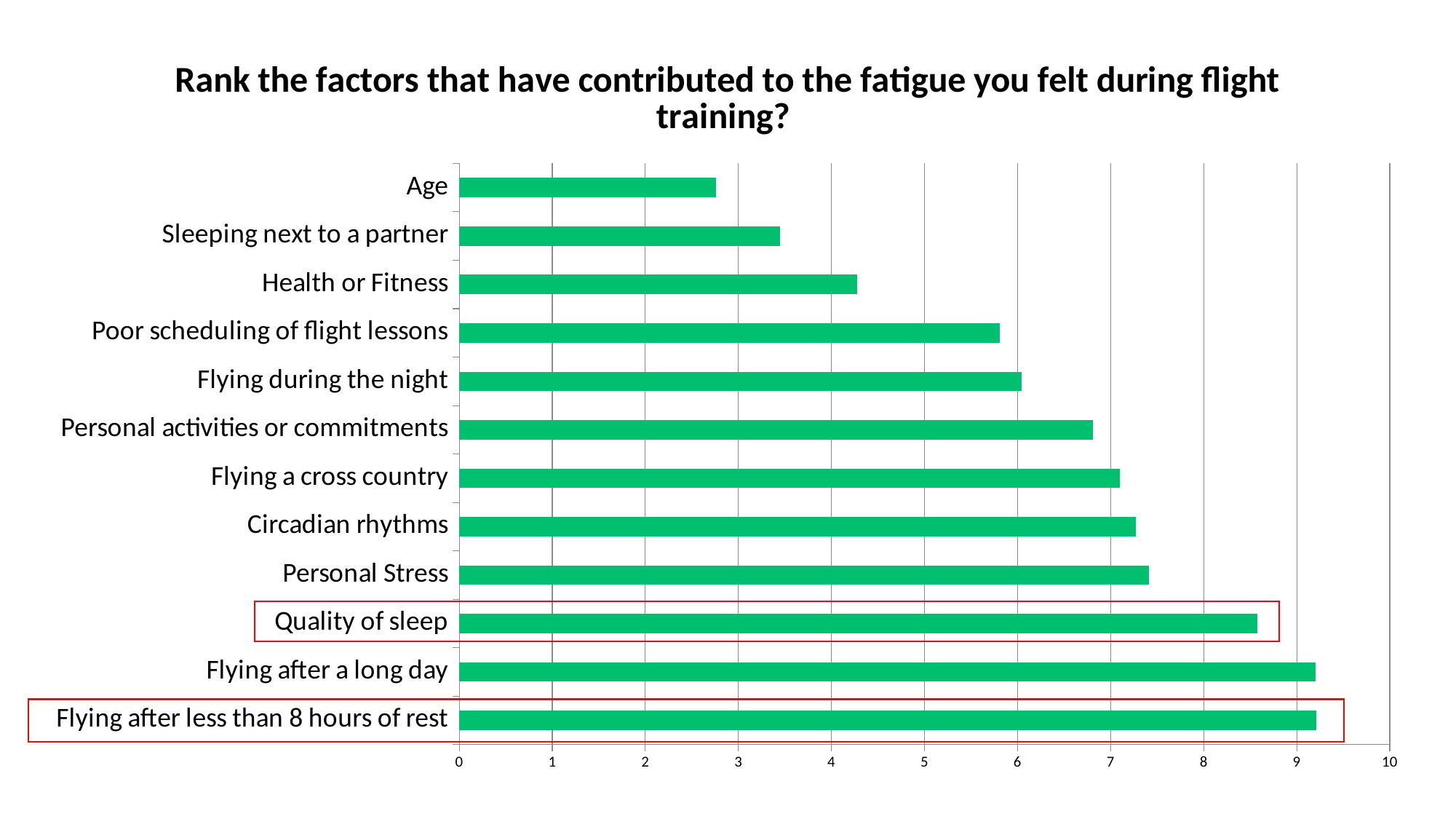
Is the value for Flying during the night greater or less than 5? greater What kind of chart is shown on the slide? bar chart What is the title of the chart? Rank the factors that have contributed to the fatigue you felt during flight training? Which factor has the lowest value in the chart? Age Which has the larger value, Poor scheduling of flight lessons or Health or Fitness? Poor scheduling of flight lessons Is the value for Flying after a long day greater or less than 9? greater How many factors (categories) are plotted in the chart? 12 Which has the larger value, Quality of sleep or Personal Stress? Quality of sleep Is the value for Age greater or less than 3? less Which two category labels are outlined with red boxes on the slide? Quality of sleep and Flying after less than 8 hours of rest